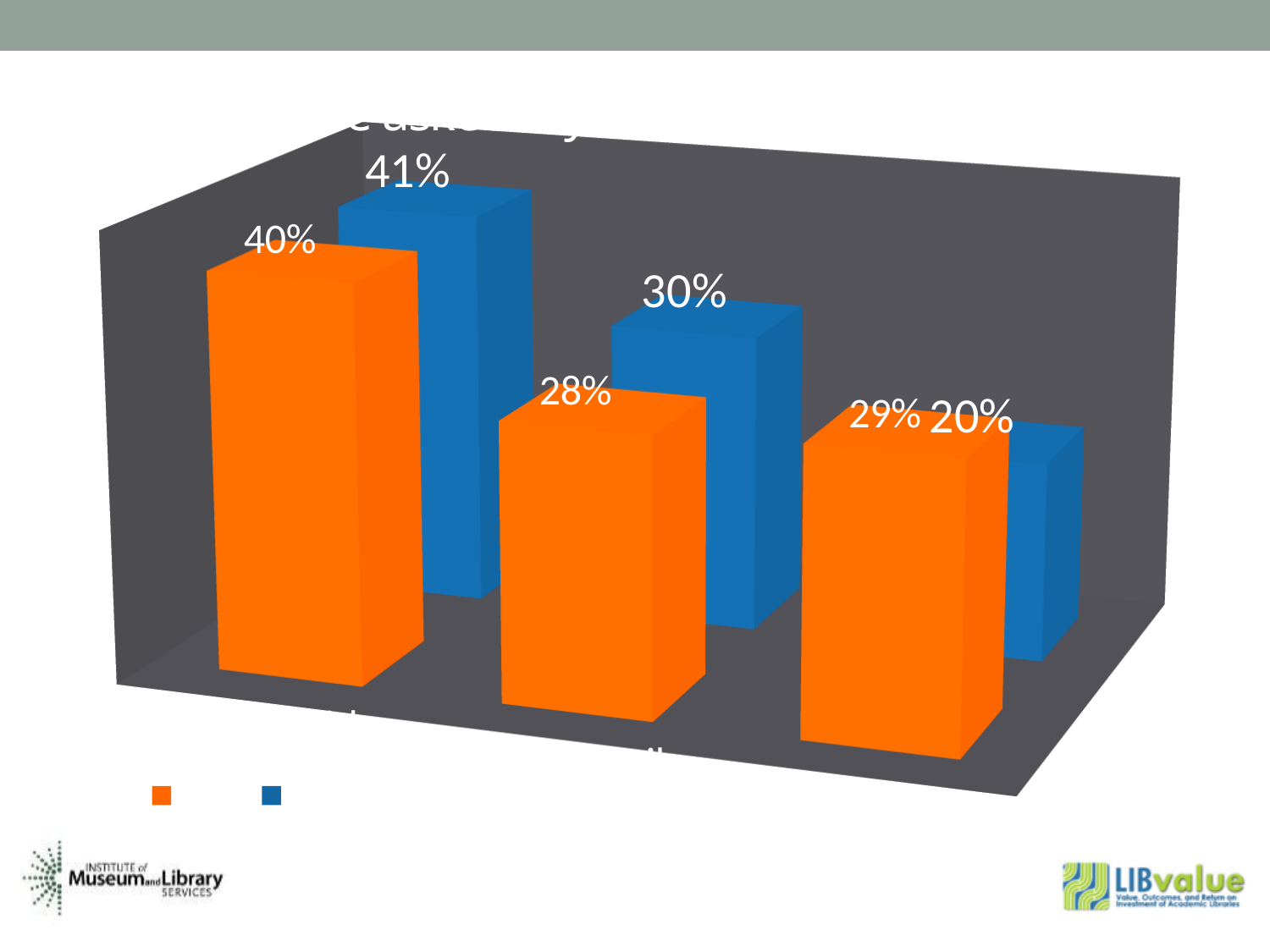
What is the value of the orange bar in the middle group? 28% In the middle group, which bar is larger, the orange or the blue? blue How many groups of bars (categories) does the chart show? 3 What is the value of the blue bar in the first (leftmost) group? 41% How many series does the chart's legend list? 2 What is the value of the orange bar in the first (leftmost) group? 40% What type of chart is shown on the slide? bar chart Which bar has the lowest value on the chart? the blue bar in the third group (20%) What is the difference between the orange and blue bars in the third (rightmost) group? 9% Which bar has the highest value on the chart? the blue bar in the first group (41%) What is the value of the blue bar in the middle group? 30% What is the value of the blue bar in the third (rightmost) group? 20%